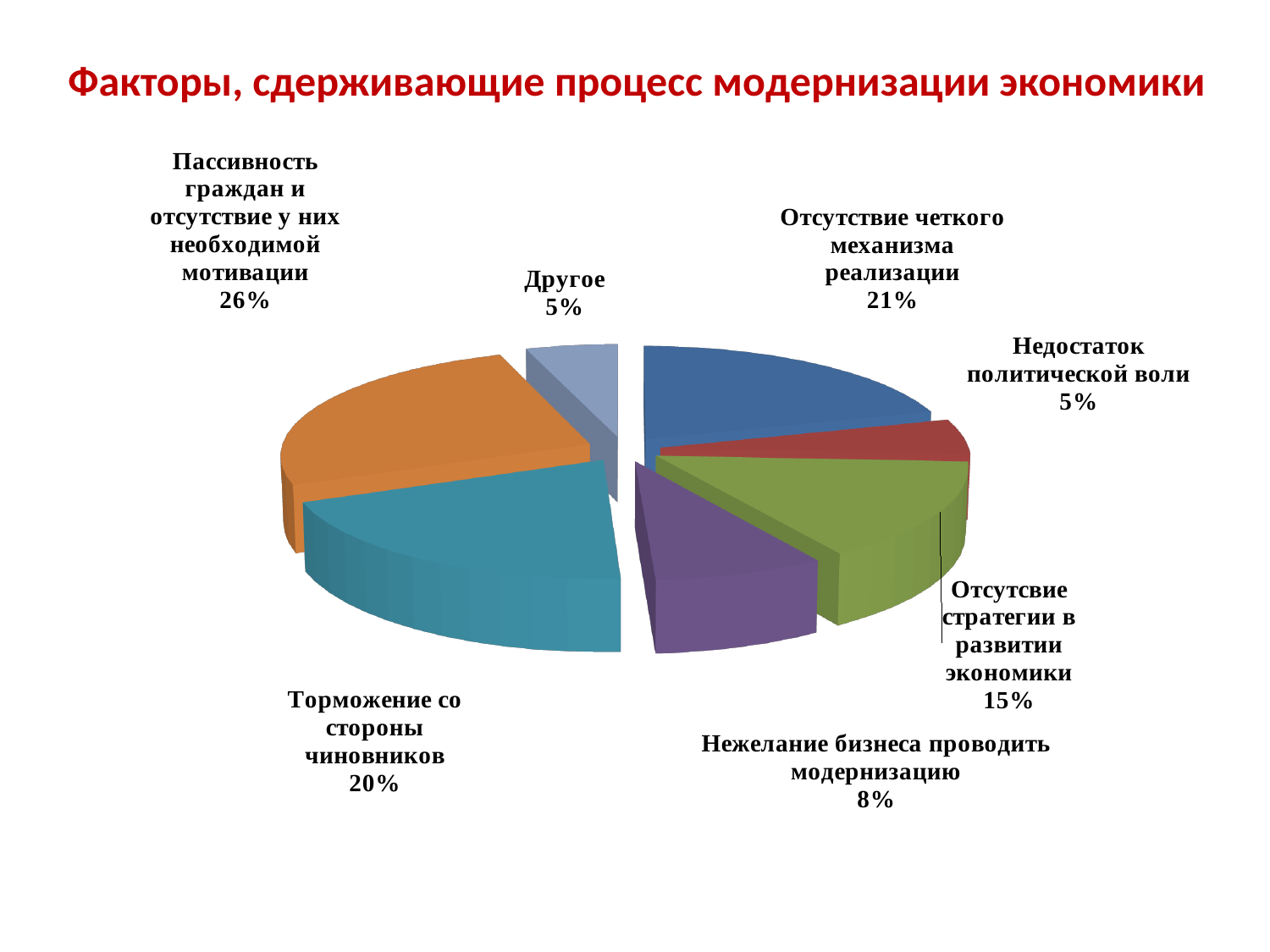
How many categories (slices) does the pie chart have? 7 Which category has the largest share of the pie? Пассивность граждан и отсутствие у них необходимой мотивации What share of the pie is labelled "Торможение со стороны чиновников"? 20% What is the title of the slide? Факторы, сдерживающие процесс модернизации экономики Which has the larger share: "Отсутсвие стратегии в развитии экономики" or "Нежелание бизнеса проводить модернизацию"? Отсутсвие стратегии в развитии экономики What share of the pie is labelled "Недостаток политической воли"? 5% What share of the pie is labelled "Пассивность граждан и отсутствие у них необходимой мотивации"? 26% What kind of chart is shown on the slide? pie chart What is the difference in percentage points between "Пассивность граждан и отсутствие у них необходимой мотивации" and "Торможение со стороны чиновников"? 6 percentage points